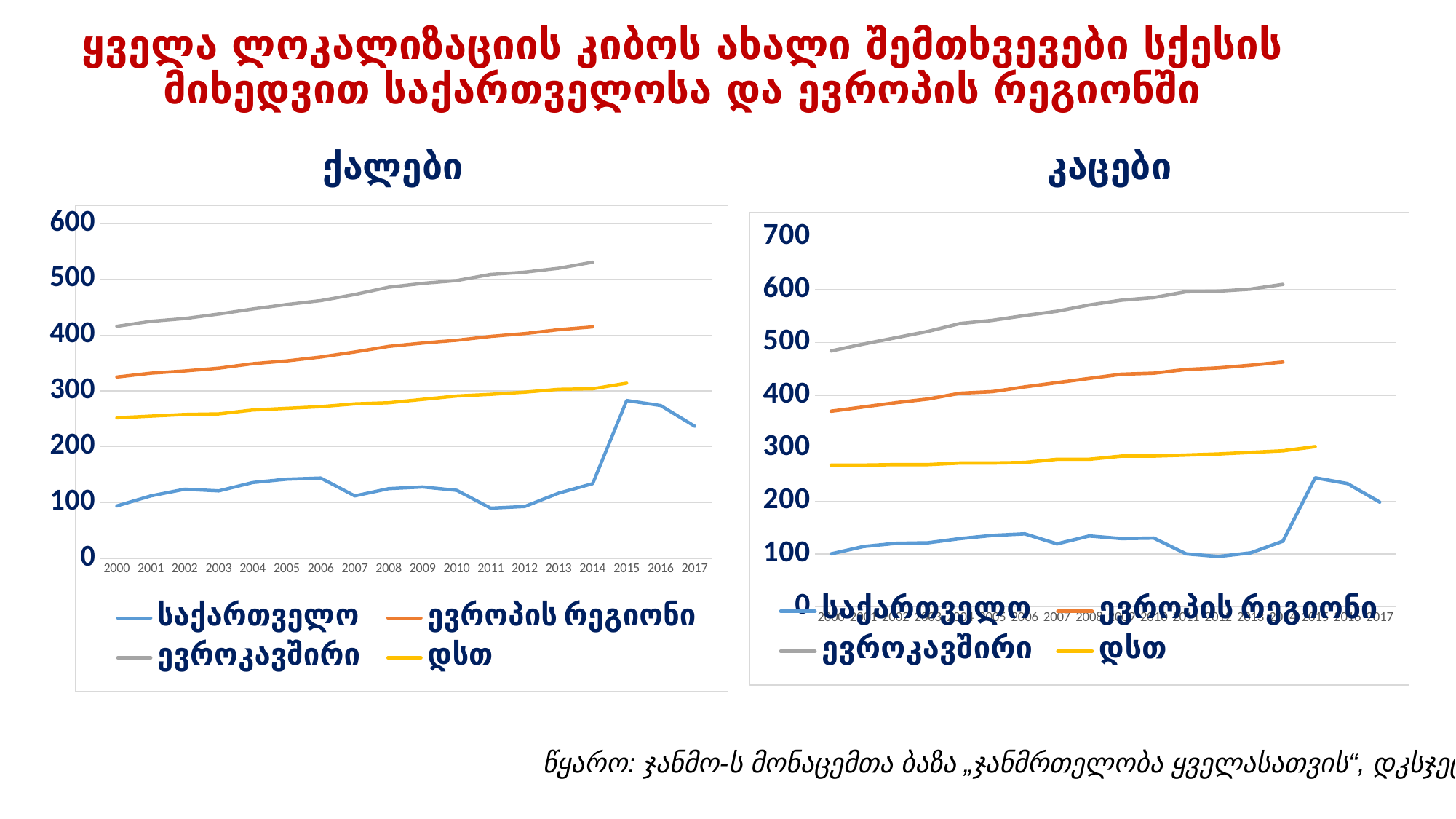
In the left chart (ქალები), is the value for ევროკავშირი in 2014 greater or less than 500? greater In the right chart (კაცები), is the value for საქართველო in 2012 greater or less than 200? less In the left chart (ქალები), is the value for საქართველო in 2015 greater or less than 200? greater In the left chart (ქალები), which series has the lowest values across the years? საქართველო In the left chart (ქალები), how many series does the legend list? 4 In the left chart (ქალები), how many years are shown on the x axis? 18 What is the title of the right chart? კაცები What kind of chart is the left chart titled ქალები? line chart In the right chart (კაცები), does the ევროკავშირი line rise or fall from 2000 to 2014? rise In the left chart (ქალები), which series has the highest values across the years? ევროკავშირი In the right chart (კაცები), which is larger in 2010: ევროპის რეგიონი or დსთ? ევროპის რეგიონი